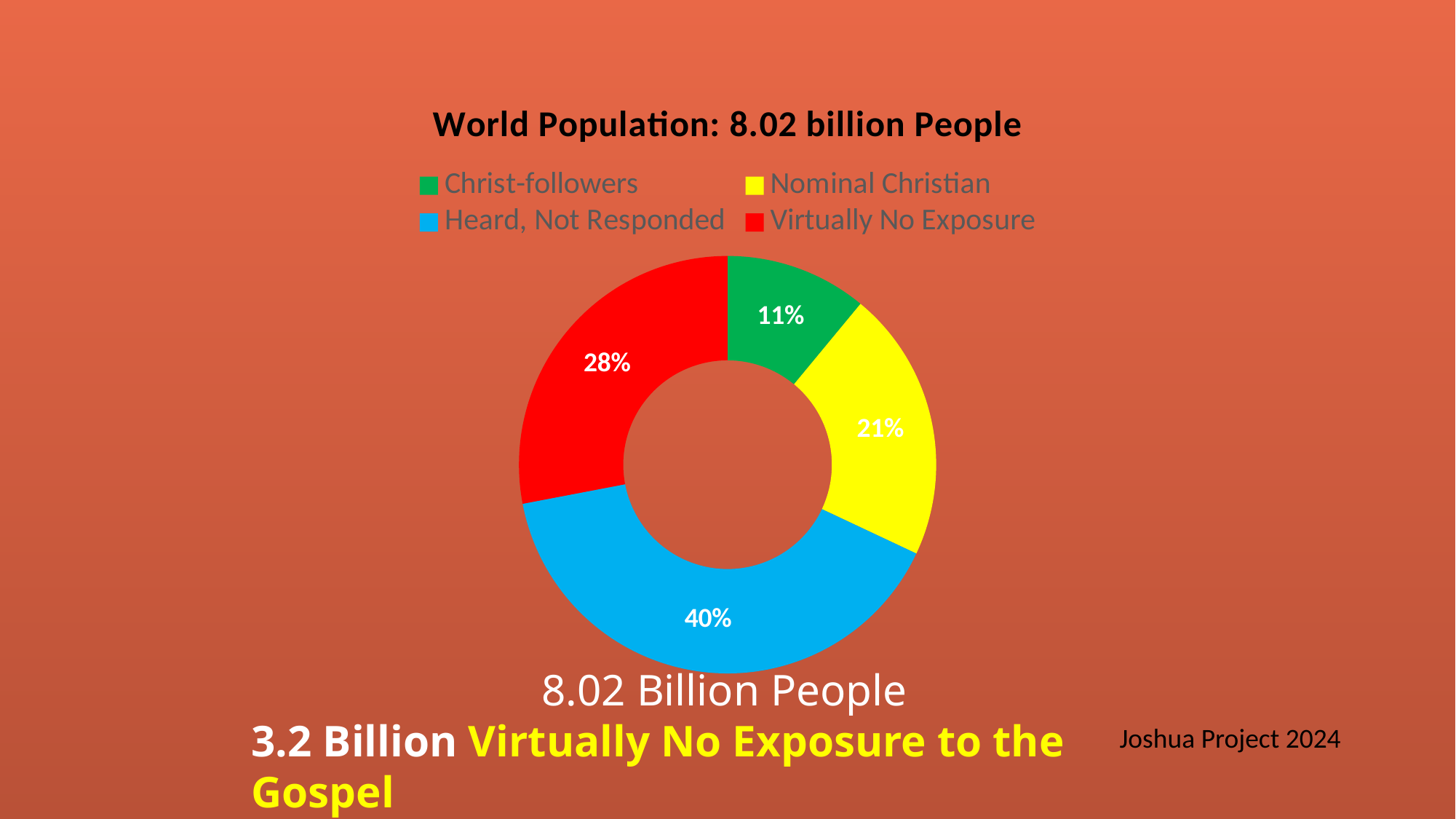
Which category has the largest share of the chart? Heard, Not Responded Which is larger, the share for Nominal Christian or the share for Virtually No Exposure? Virtually No Exposure What percentage is shown for Heard, Not Responded? 40% Which colour represents Virtually No Exposure in the chart? Red What percentage is shown for Virtually No Exposure? 28% What percentage is shown for Nominal Christian? 21% What is the title of the chart? World Population: 8.02 billion People What percentage of the world population is shown as Christ-followers? 11% What is the difference in percentage points between Heard, Not Responded and Virtually No Exposure? 12 How many categories does the chart show? 4 Which category has the smallest share of the chart? Christ-followers What kind of chart is shown on the slide? Doughnut chart